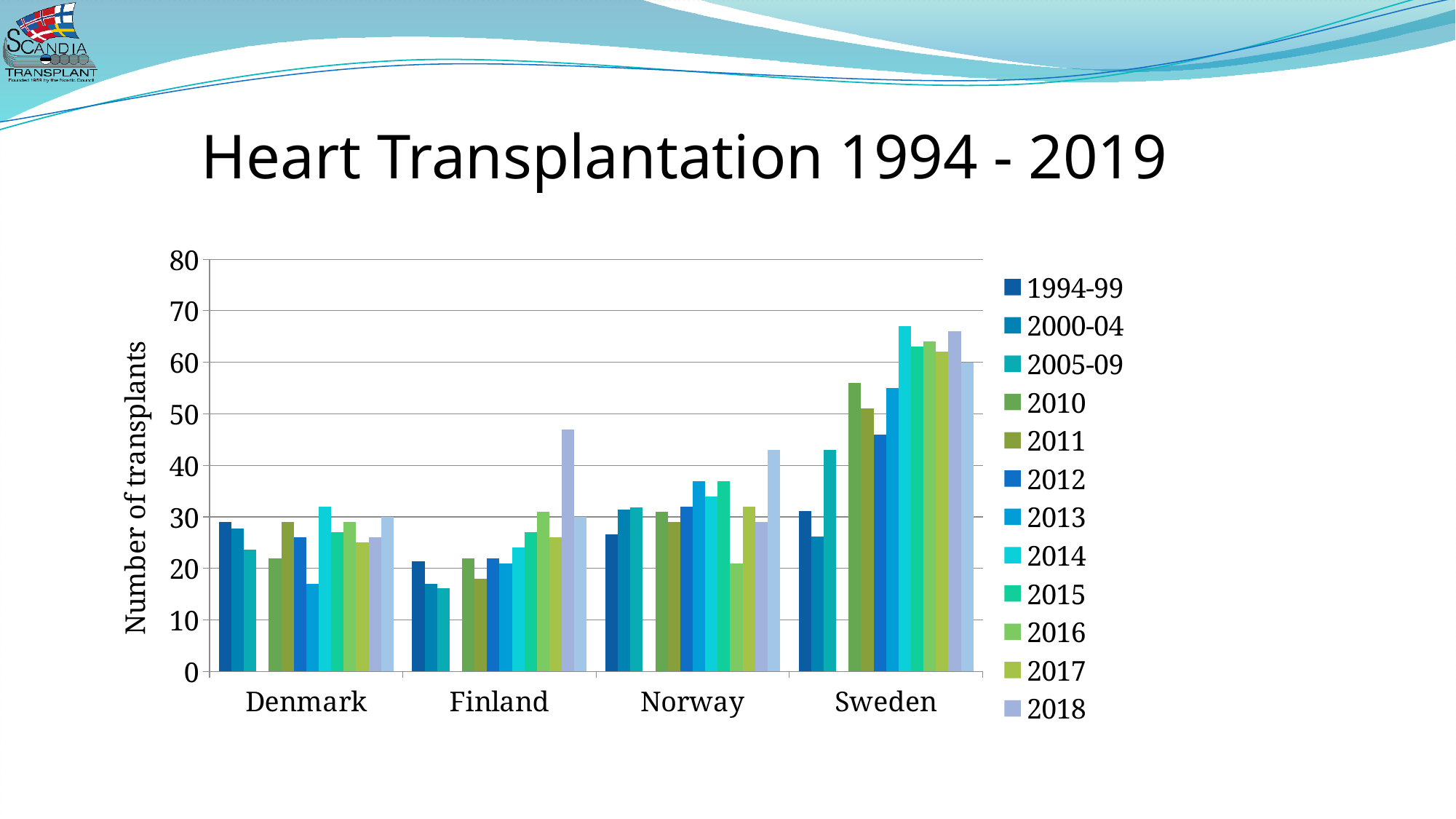
Is the value for Sweden in 2014 greater or less than 60? greater Is the value for Denmark in 2013 greater or less than 20? less Which is larger, the value for Sweden in 2014 or the value for Denmark in 2014? Sweden in 2014 How many series does the chart legend list? 12 Is the value for Finland in 2018 greater or less than 40? greater How many countries are shown on the x axis of the chart? 4 What is the label of the vertical axis? Number of transplants Which country has the highest number of heart transplants in the chart? Sweden Which is larger, the value for Norway in 2018 or the value for Denmark in 2018? Norway in 2018 What is the title of the chart on the slide? Heart Transplantation 1994 - 2019 What kind of chart is shown on the slide? bar chart